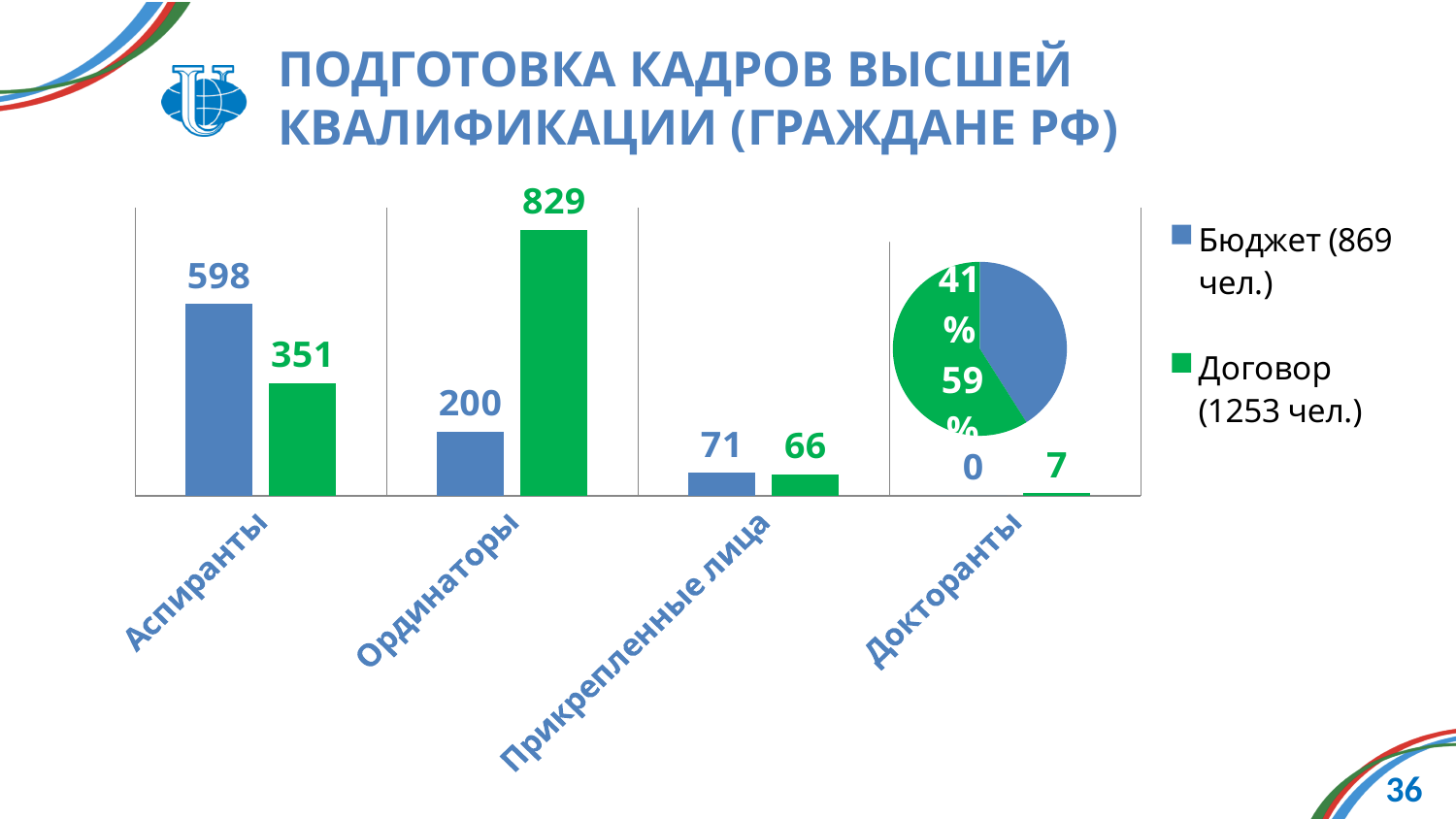
In the bar chart, which category has the highest Договор value? Ординаторы According to the legend, how many people are in the Бюджет series? 869 чел. How many series does the legend list? 2 What kind of chart is the large chart on the left of the slide? bar chart In the pie chart, what share does the green (Договор) slice have? 59% In the bar chart, what is the Бюджет value for Аспиранты? 598 How many categories are shown on the x axis of the bar chart? 4 In the bar chart, what is the Договор value for Докторанты? 7 In the bar chart, which is larger for Прикрепленные лица: Бюджет or Договор? Бюджет In the bar chart, what is the difference between the Бюджет and Договор values for Аспиранты? 247 In the bar chart, which category has the lowest Бюджет value? Докторанты In the bar chart, what is the Договор value for Ординаторы? 829